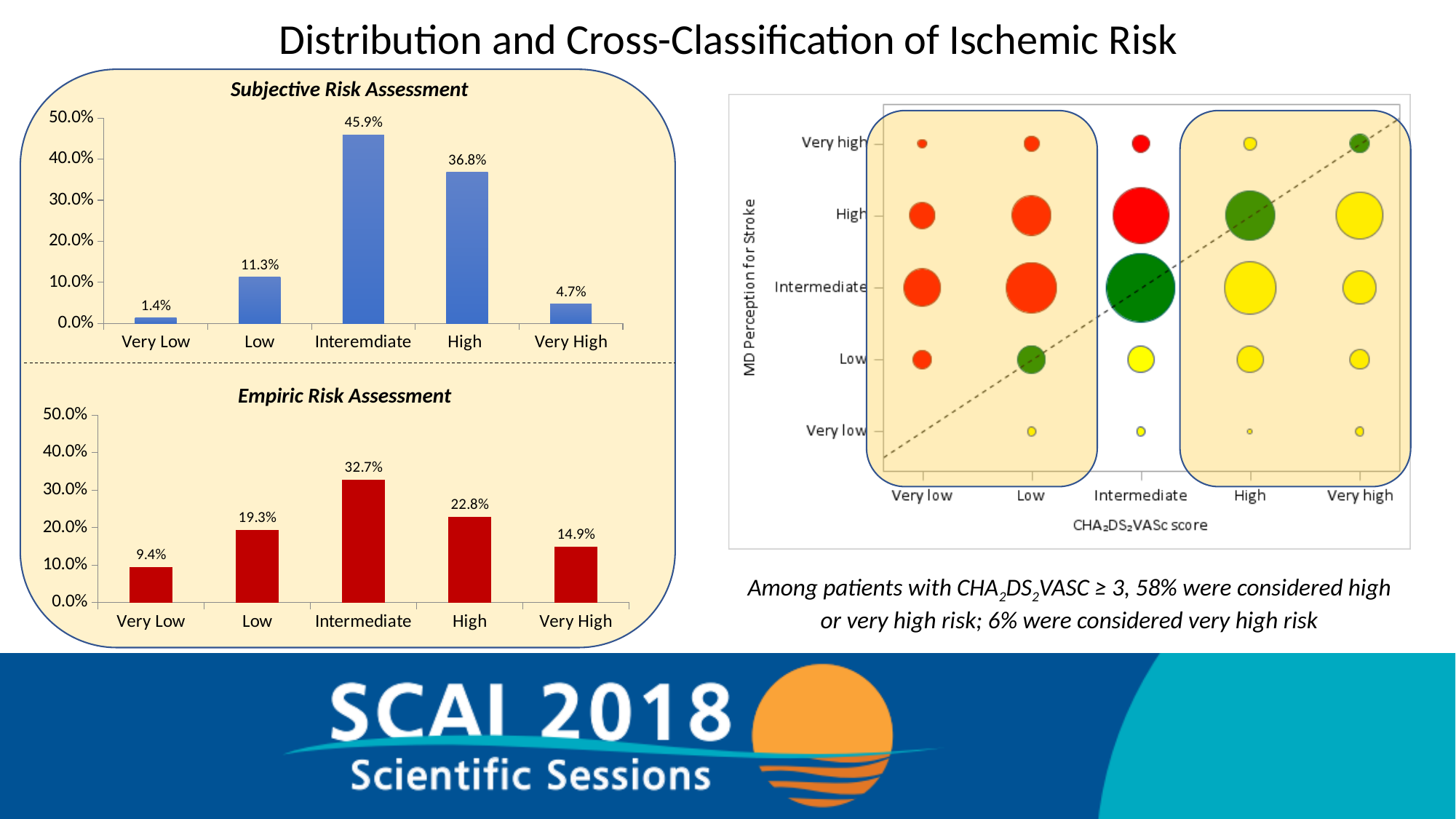
What is the x-axis label of the bubble chart on the right of the slide? CHA₂DS₂VASc score How many categories are shown in the Empiric Risk Assessment chart? 5 In the Empiric Risk Assessment chart, what is the value for Very High? 14.9% What kind of chart is the Subjective Risk Assessment chart? bar chart In the Subjective Risk Assessment chart, which category has the lowest value? Very Low In the Empiric Risk Assessment chart, which is larger, the value for Low or the value for High? High In the Subjective Risk Assessment chart, what is the difference between the High and Low values? 25.5% In the Subjective Risk Assessment chart, what is the value for Intermediate? 45.9% In the Empiric Risk Assessment chart, which category has the highest value? Intermediate In the Empiric Risk Assessment chart, what is the value for Low? 19.3% In the Subjective Risk Assessment chart, is the value for High greater or less than 30.0%? greater In the Empiric Risk Assessment chart, what is the difference between the Intermediate and Very Low values? 23.3%